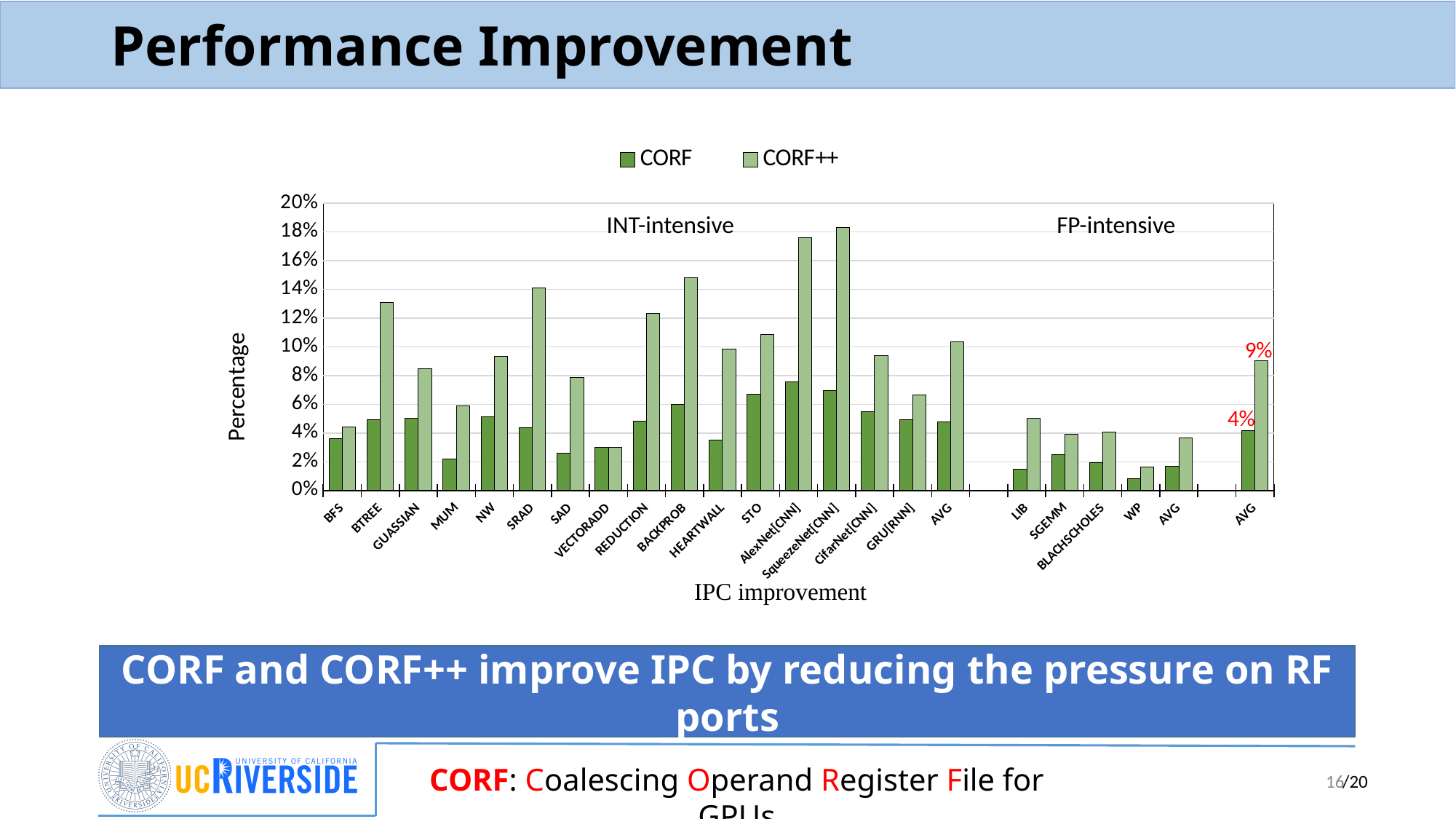
What is the label on the vertical axis of the chart? Percentage Which has the larger CORF++ value, BTREE or GUASSIAN? BTREE What is the CORF value for the rightmost AVG category, as labelled on the chart? 4% Is the CORF value for MUM greater or less than 4%? less What is the difference between the CORF++ and CORF values for the rightmost AVG category? 5% How many series does the legend list? 2 What kind of chart is shown on the slide? Bar chart Which category has the lowest CORF value? WP What is the CORF++ value for the rightmost AVG category, as labelled on the chart? 9% How many categories, including AVG, are in the FP-intensive group? 5 Is the CORF++ value for BTREE greater or less than 12%? greater Is the CORF++ value for SqueezeNet[CNN] greater or less than 16%? greater